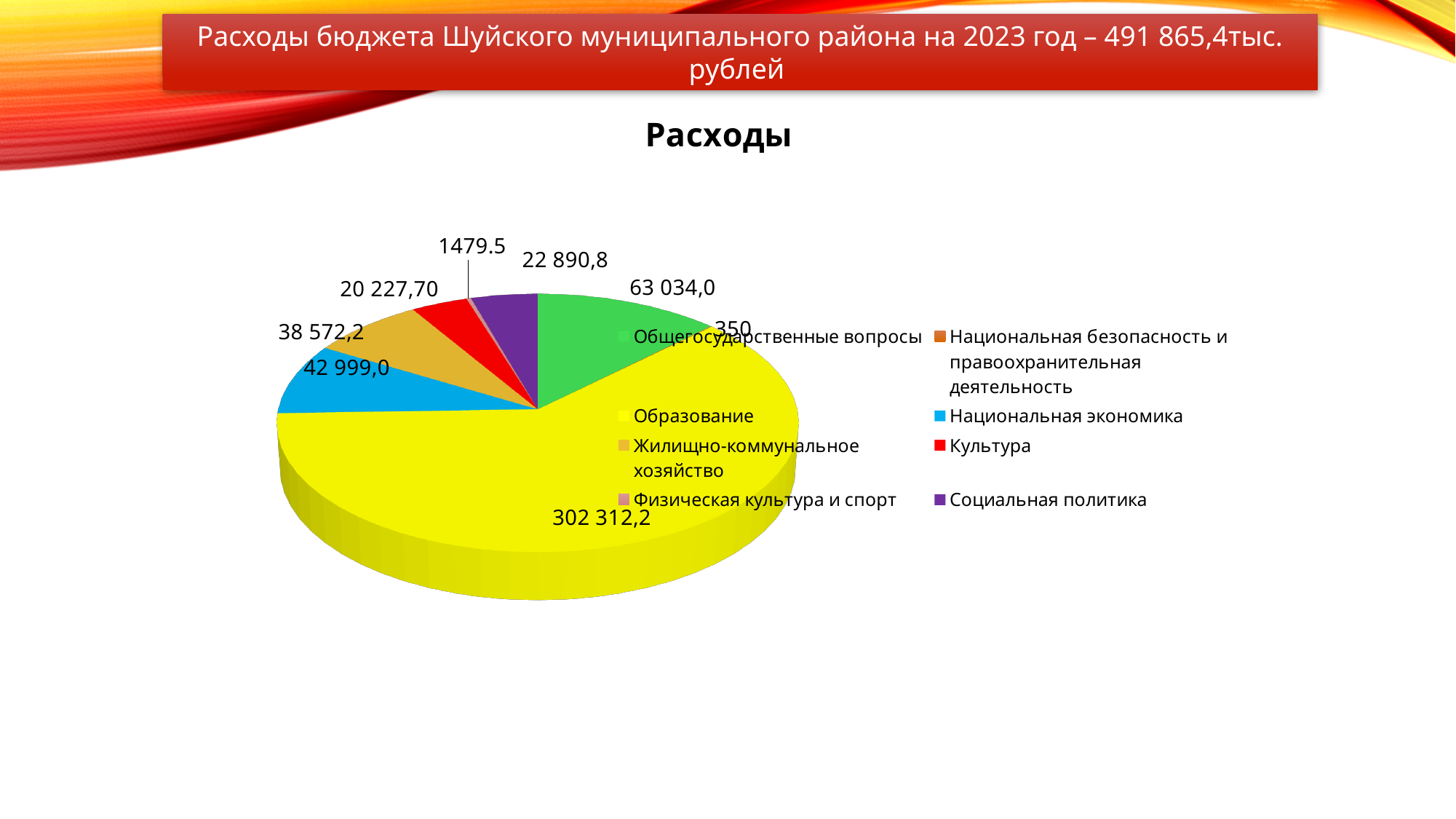
What is the title of the chart? Расходы Which category has the smallest value? Национальная безопасность и правоохранительная деятельность What is the difference between Общегосударственные вопросы and Национальная экономика? 20 035,0 What is the value for Образование in the pie chart? 302 312,2 What kind of chart is shown on the slide? pie chart Which category has the largest slice of the pie? Образование What is the value for Культура? 20 227,70 Which is larger, Жилищно-коммунальное хозяйство or Социальная политика? Жилищно-коммунальное хозяйство What is the value for Общегосударственные вопросы? 63 034,0 What is the value for Социальная политика? 22 890,8 What is the value for Национальная экономика? 42 999,0 How many categories does the pie chart have? 8